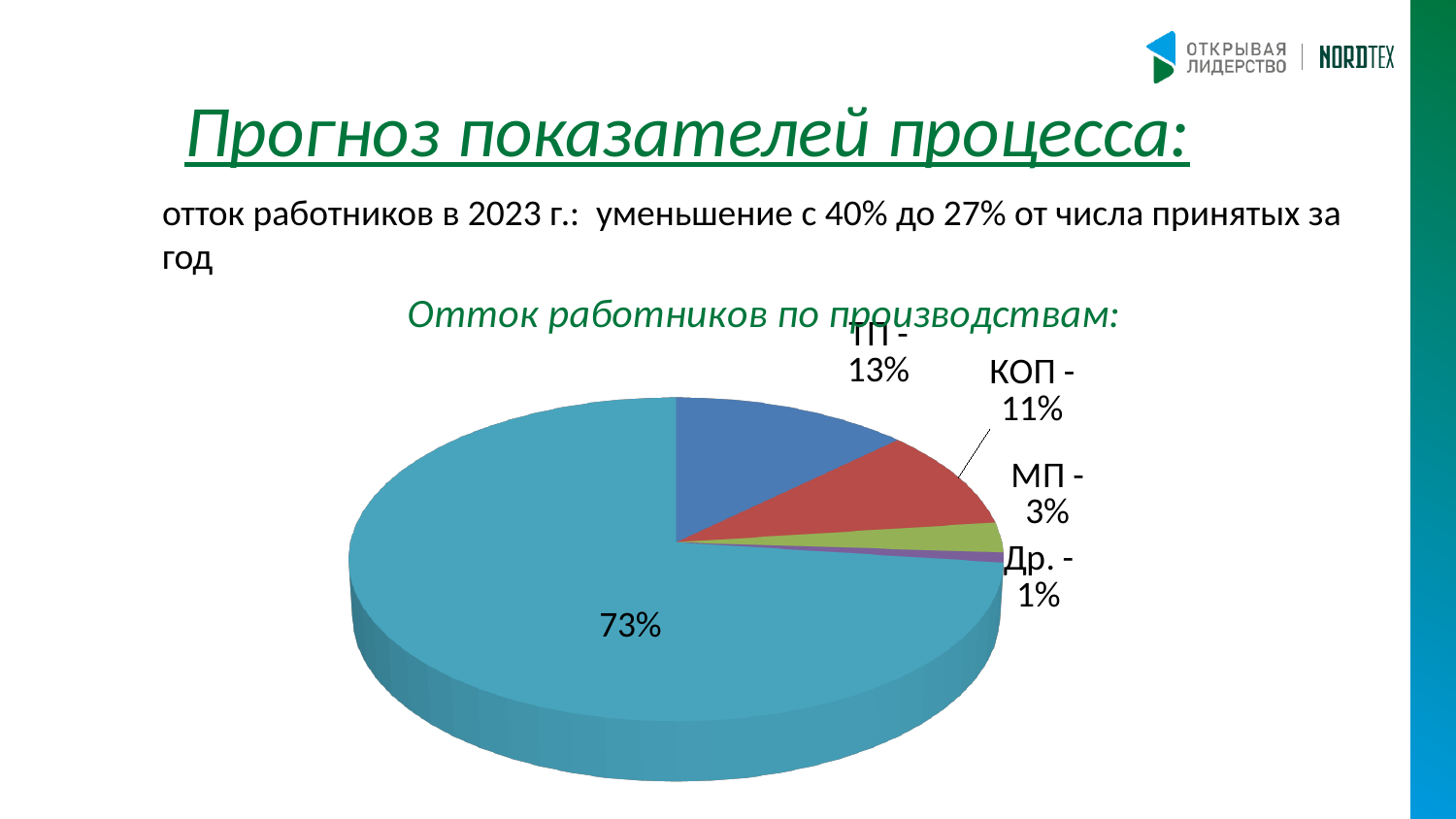
What share of the pie does the slice labelled КОП have? 11% Which labelled slice has the smallest share of the pie? Др. What share of the pie does the slice labelled МП have? 3% What percentage is shown on the largest slice of the pie? 73% What share of the pie does the slice labelled Др. have? 1% What is the difference in percentage points between the ТП slice and the МП slice? 10% What colour is the largest slice of the pie? teal (light blue) How many slices does the pie chart have? 5 What kind of chart is shown on the slide? pie chart What is the title of the chart? Отток работников по производствам: Which slice is larger, ТП or КОП? ТП